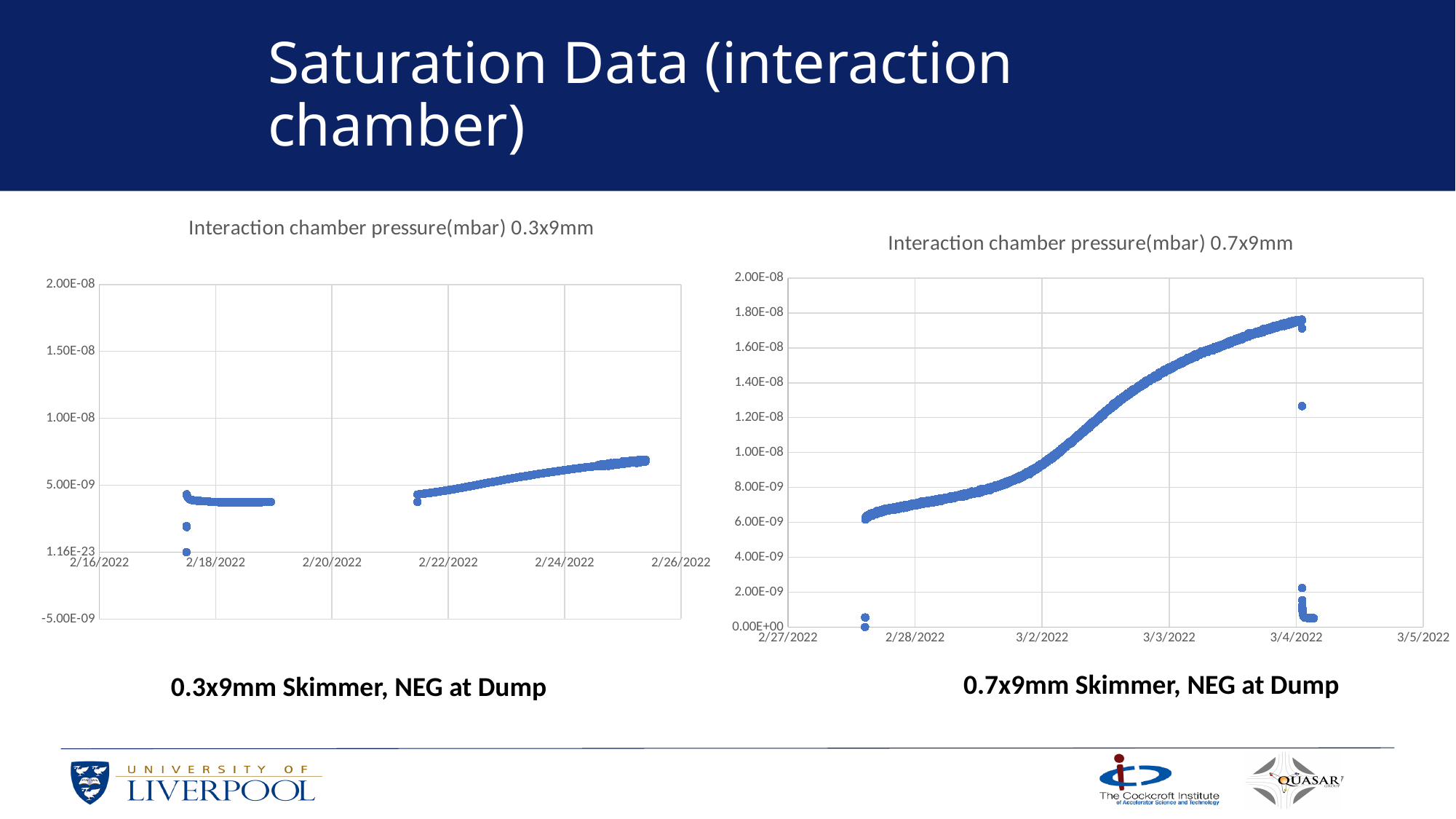
In the right chart (0.7x9mm), is the pressure value at 3/3/2022 greater or less than 1.00E-08? greater In the right chart (0.7x9mm), is the pressure value at 2/28/2022 greater or less than 8.00E-09? less How many charts are shown on the slide? 2 In the left chart (0.3x9mm), do the pressure values rise or fall between 2/22/2022 and 2/26/2022? rise In the left chart (0.3x9mm), is the pressure value at 2/24/2022 greater or less than 1.00E-08? less Which chart reaches a higher maximum pressure, the 0.3x9mm chart or the 0.7x9mm chart? 0.7x9mm chart What kind of chart is the left chart titled 'Interaction chamber pressure(mbar) 0.3x9mm'? scatter chart What is the title of the left chart? Interaction chamber pressure(mbar) 0.3x9mm In the right chart (0.7x9mm), do the pressure values rise or fall from 2/28/2022 to 3/4/2022? rise What kind of chart is the right chart titled 'Interaction chamber pressure(mbar) 0.7x9mm'? scatter chart What is the caption printed below the right chart? 0.7x9mm Skimmer, NEG at Dump